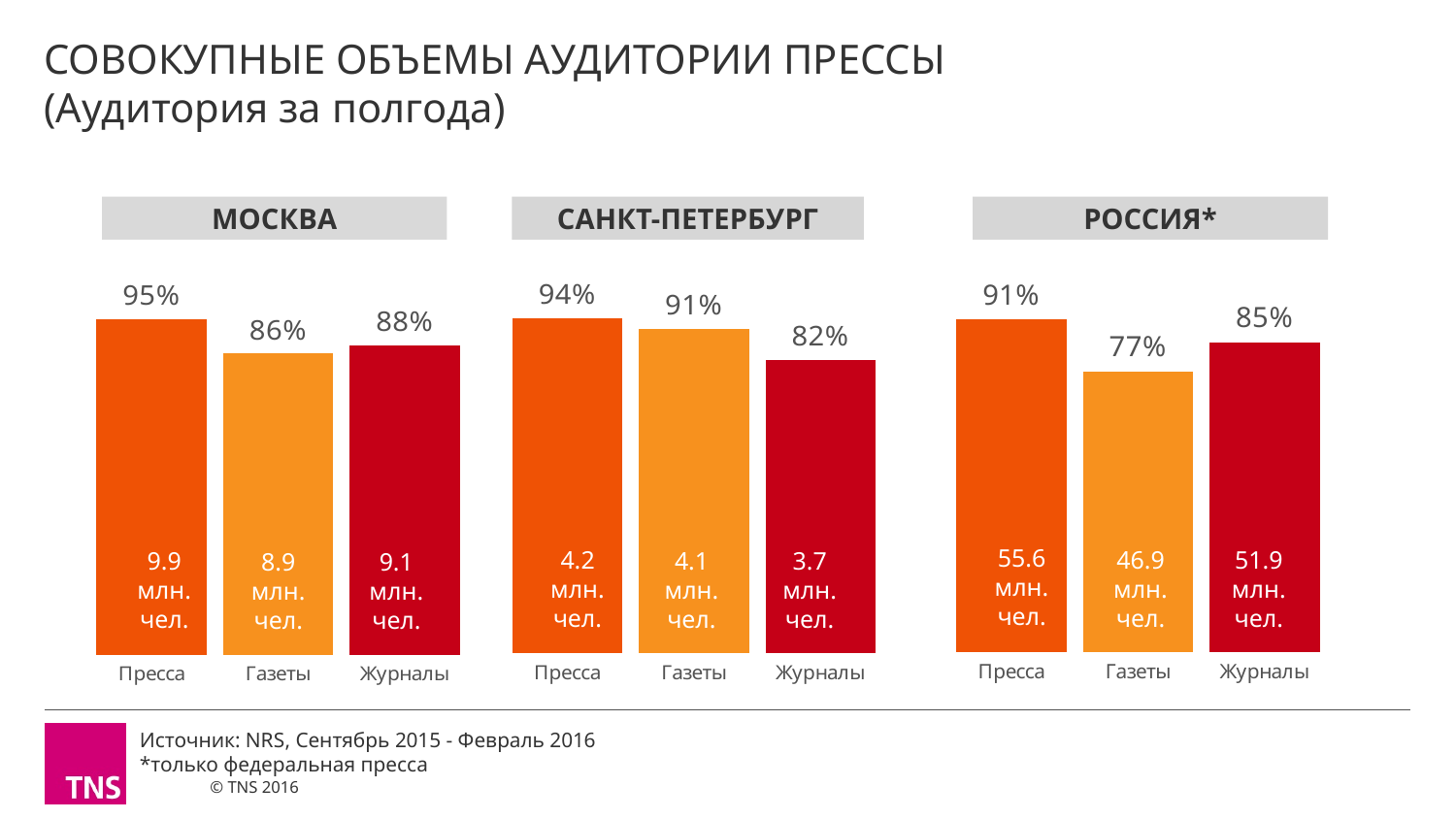
In the САНКТ-ПЕТЕРБУРГ chart, what is the difference in percentage points between Пресса and Журналы? 12 How many bars are in the САНКТ-ПЕТЕРБУРГ chart? 3 In the РОССИЯ* chart, how many million people are shown for Пресса? 55.6 млн. чел. In the РОССИЯ* chart, what percentage is shown for Газеты? 77% What is the title of the slide? СОВОКУПНЫЕ ОБЪЕМЫ АУДИТОРИИ ПРЕССЫ (Аудитория за полгода) In the САНКТ-ПЕТЕРБУРГ chart, how many million people are shown for Журналы? 3.7 млн. чел. In the МОСКВА chart, which is larger, the percentage for Газеты or for Журналы? Журналы In the МОСКВА chart, what percentage is shown for Пресса? 95% In the РОССИЯ* chart, which category has the highest percentage? Пресса In the МОСКВА chart, what is the difference in million people between Пресса and Газеты? 1.0 млн. чел. In the МОСКВА chart, which category has the lowest percentage? Газеты What type of chart is used for МОСКВА? Bar chart